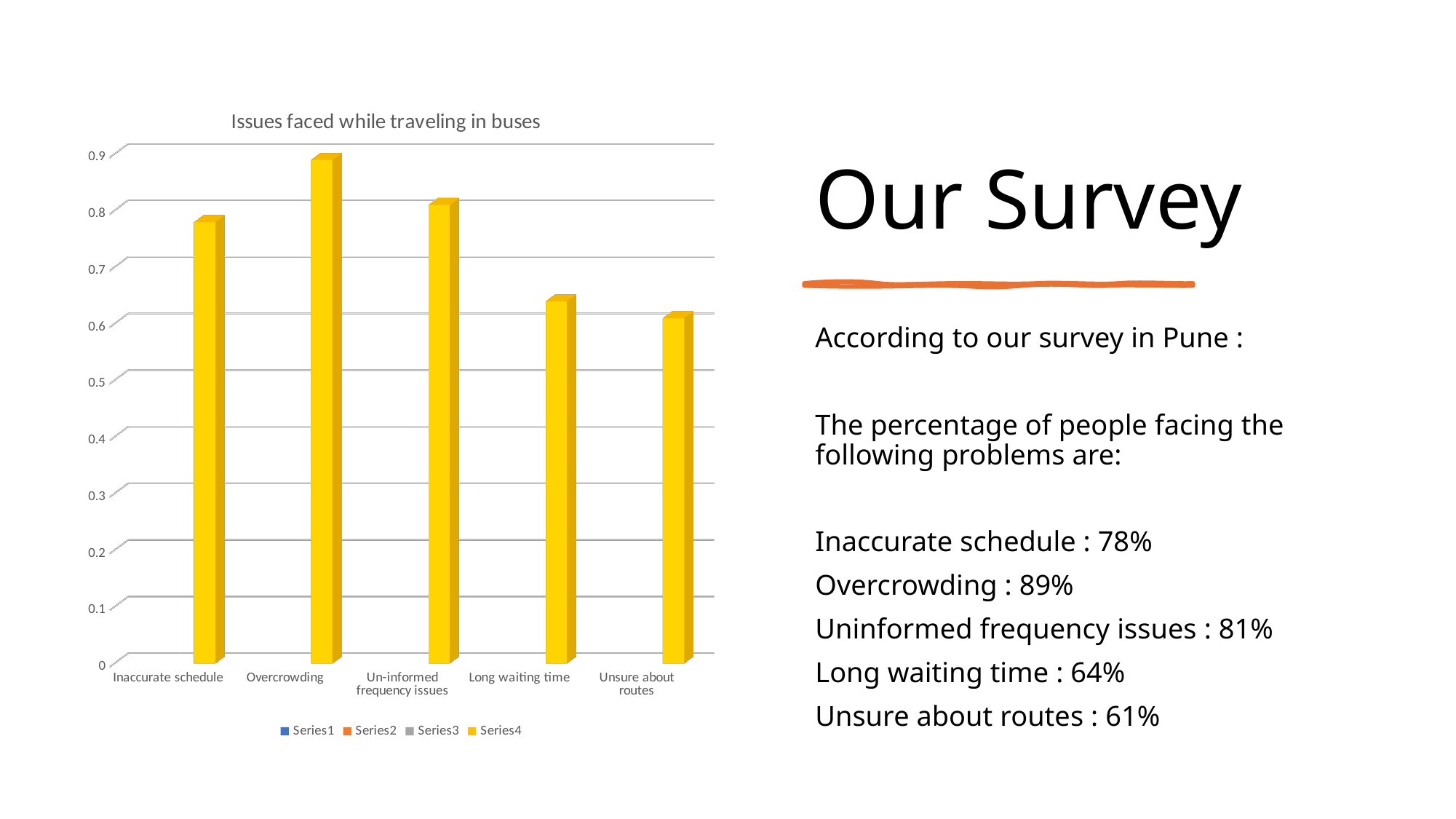
How many categories are shown on the x axis of the chart? 5 Is the value for Inaccurate schedule greater or less than 0.7? greater Which is larger, the value for Un-informed frequency issues or the value for Long waiting time? Un-informed frequency issues What type of chart is shown on the slide? bar chart Which is larger, the value for Overcrowding or the value for Inaccurate schedule? Overcrowding How many series does the chart legend list? 4 What is the title of the chart? Issues faced while traveling in buses Which category has the highest bar in the chart? Overcrowding Which category has the lowest bar in the chart? Unsure about routes Is the value for Overcrowding greater or less than 0.8? greater Is the value for Unsure about routes greater or less than 0.7? less